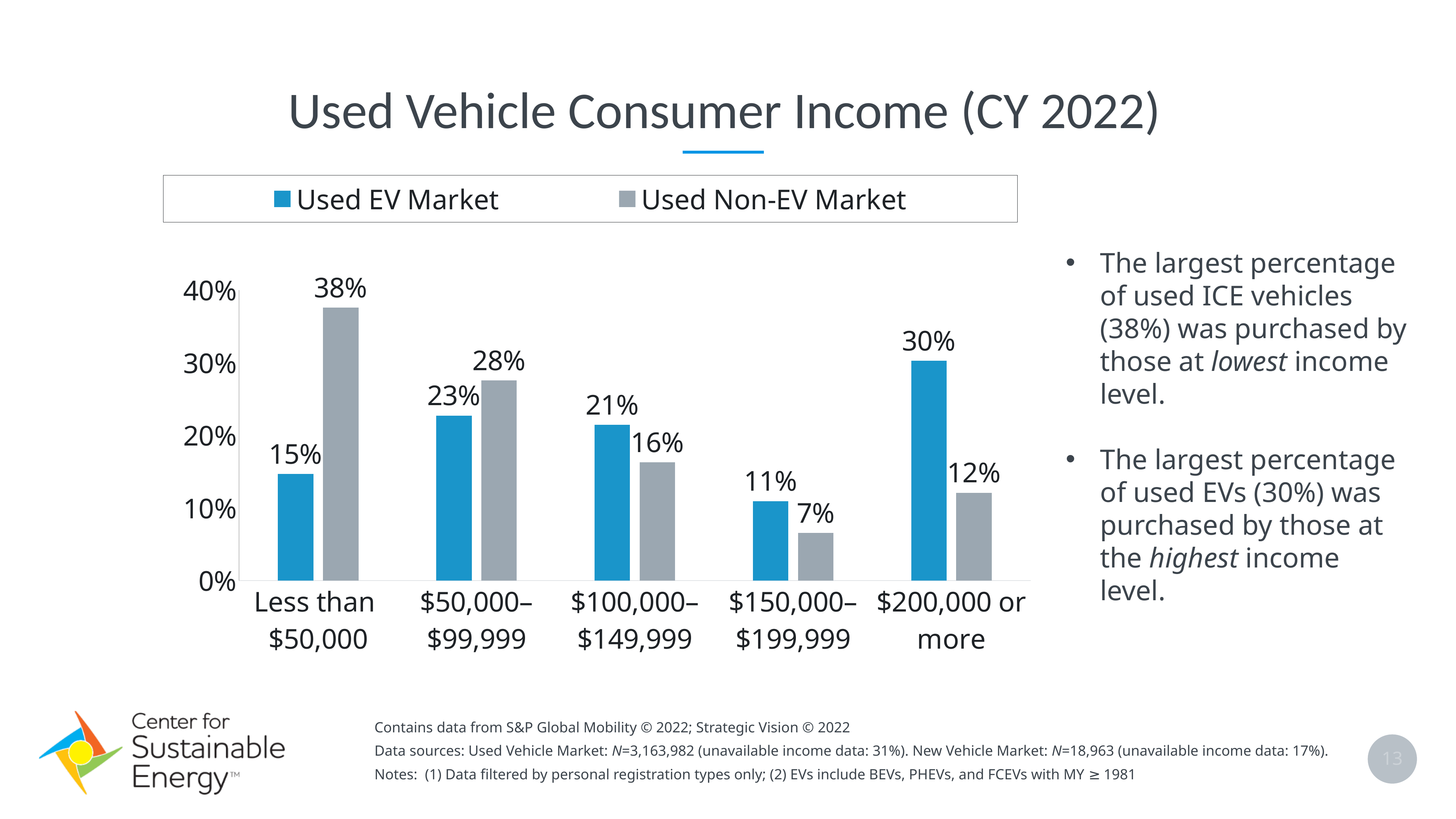
What is the Used EV Market value for the $150,000–$199,999 income category? 11% What colour are the Used EV Market bars? Blue For the $100,000–$149,999 category, which is larger: the Used EV Market value or the Used Non-EV Market value? Used EV Market Which income category has the lowest Used EV Market value? $150,000–$199,999 Which income category has the highest Used Non-EV Market value? Less than $50,000 Does the Used Non-EV Market value rise or fall from the Less than $50,000 category to the $150,000–$199,999 category? Fall How many series does the legend list? 2 What is the Used EV Market value for the $200,000 or more income category? 30% How many income categories are shown on the x axis? 5 What is the Used Non-EV Market value for the Less than $50,000 income category? 38% What kind of chart is shown on the slide? Bar chart What is the difference between the Used Non-EV Market and Used EV Market values for the Less than $50,000 category? 23%